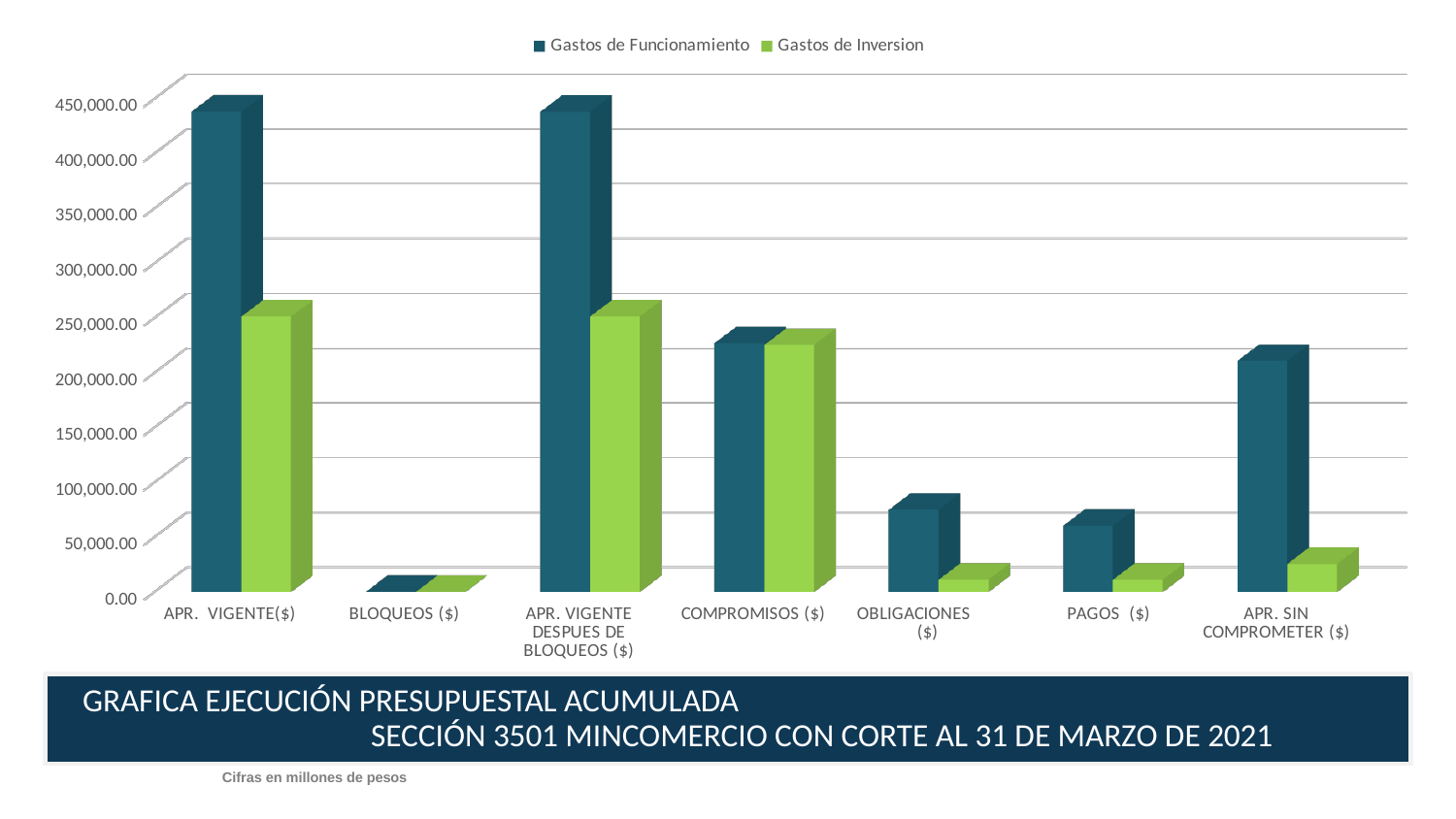
Is the Gastos de Inversion value for APR. SIN COMPROMETER ($) greater or less than 50,000.00? less How many series does the legend list? 2 Is the Gastos de Funcionamiento value for APR. SIN COMPROMETER ($) greater or less than 150,000.00? greater What kind of chart is shown on the slide? bar chart Is the Gastos de Inversion value for APR. VIGENTE($) greater or less than 300,000.00? less For OBLIGACIONES ($), which series has the larger value, Gastos de Funcionamiento or Gastos de Inversion? Gastos de Funcionamiento Which series is shown in green in the legend? Gastos de Inversion How many categories are shown on the x axis? 7 Which is larger for Gastos de Funcionamiento, OBLIGACIONES ($) or PAGOS ($)? OBLIGACIONES ($) Which category has the lowest Gastos de Funcionamiento value? BLOQUEOS ($)